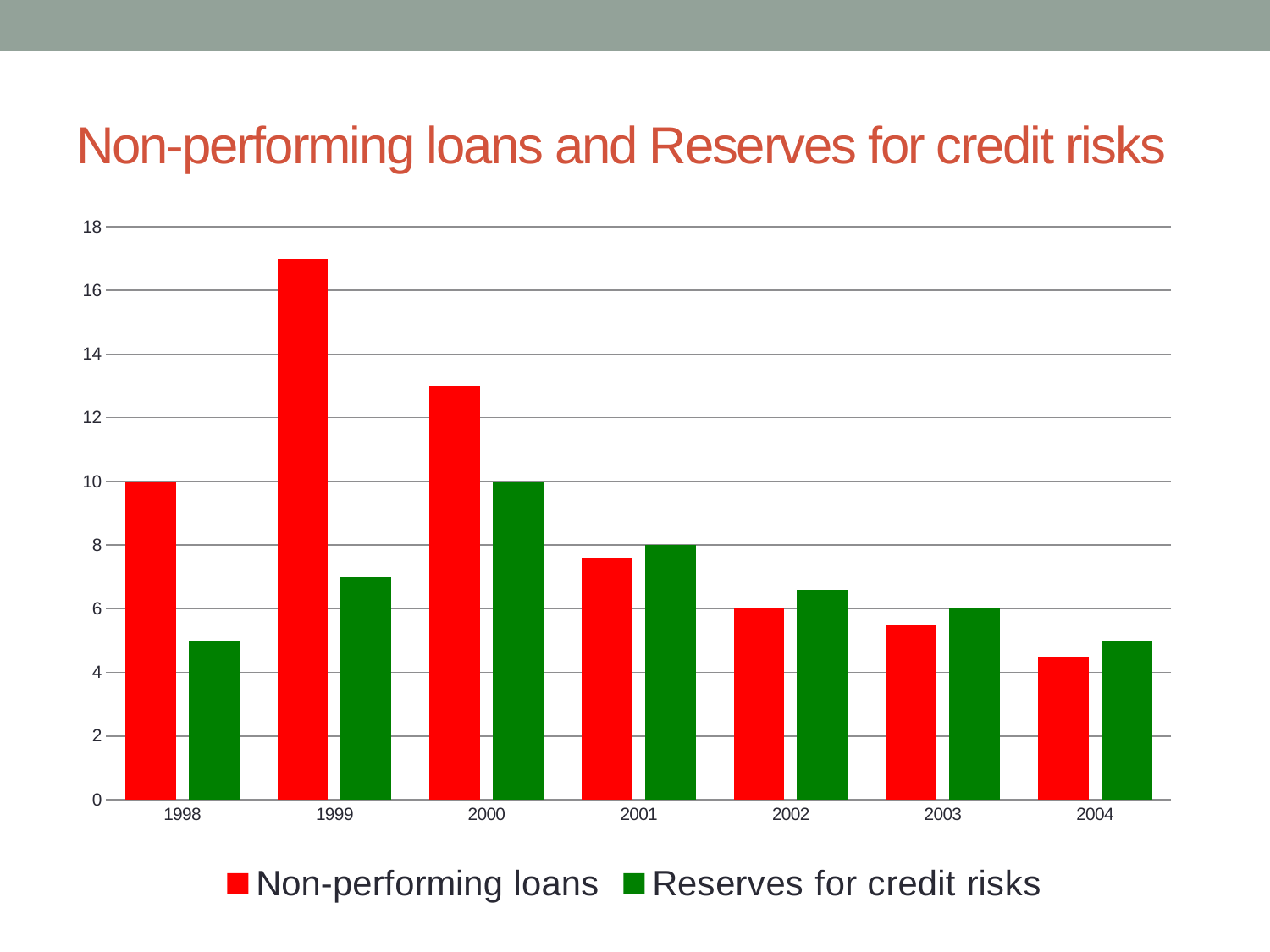
Is the value for Non-performing loans in 2004 greater or less than 6? less What is the value of Reserves for credit risks in 2000? 10 Is the value for Non-performing loans in 1999 greater or less than 16? greater What is the value of Non-performing loans in 2002? 6 In which year are Non-performing loans lowest? 2004 In which year are Non-performing loans highest? 1999 What type of chart is shown on the slide? Bar chart What is the value of Non-performing loans in 1998? 10 How many series does the legend list? 2 In 2002, which is larger: Non-performing loans or Reserves for credit risks? Reserves for credit risks What is the value of Reserves for credit risks in 2001? 8 How many years are shown on the x axis? 7